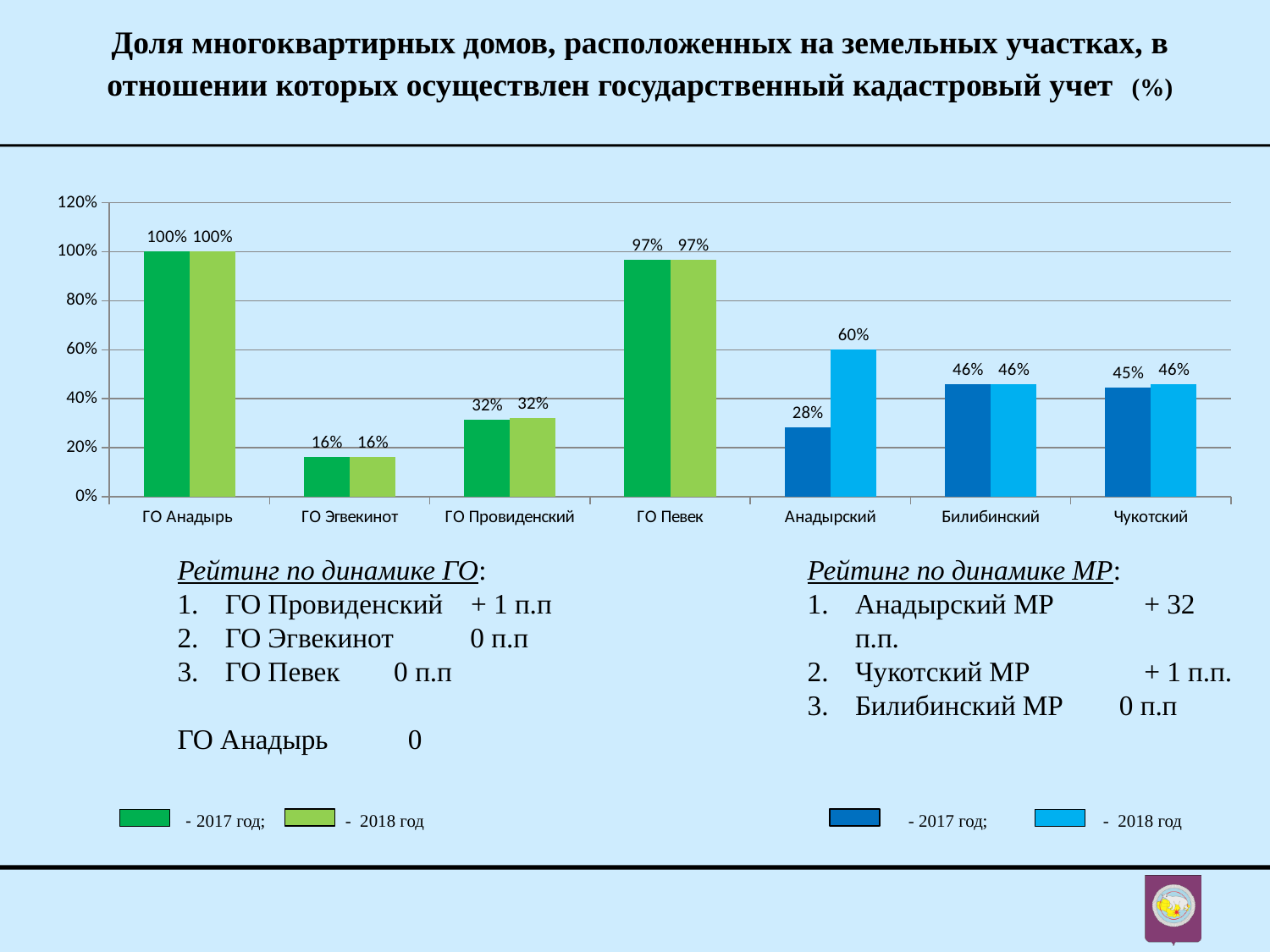
What is the 2017 value for Анадырский? 28% What is the 2018 value for Чукотский? 46% What is the difference between the 2018 and 2017 values for Анадырский? 32% Which two years do the legends distinguish? 2017 and 2018 Which category has the highest 2018 value? ГО Анадырь What is the difference between the 2017 values for ГО Провиденский and ГО Эгвекинот? 16% What is the 2017 value for ГО Эгвекинот? 16% Which category has the lowest 2017 value? ГО Эгвекинот What is the 2018 value for Анадырский? 60% How many categories are shown on the x axis of the chart? 7 Which is larger: the 2017 value for ГО Певек or the 2017 value for Билибинский? ГО Певек What kind of chart is shown on the slide? Bar chart